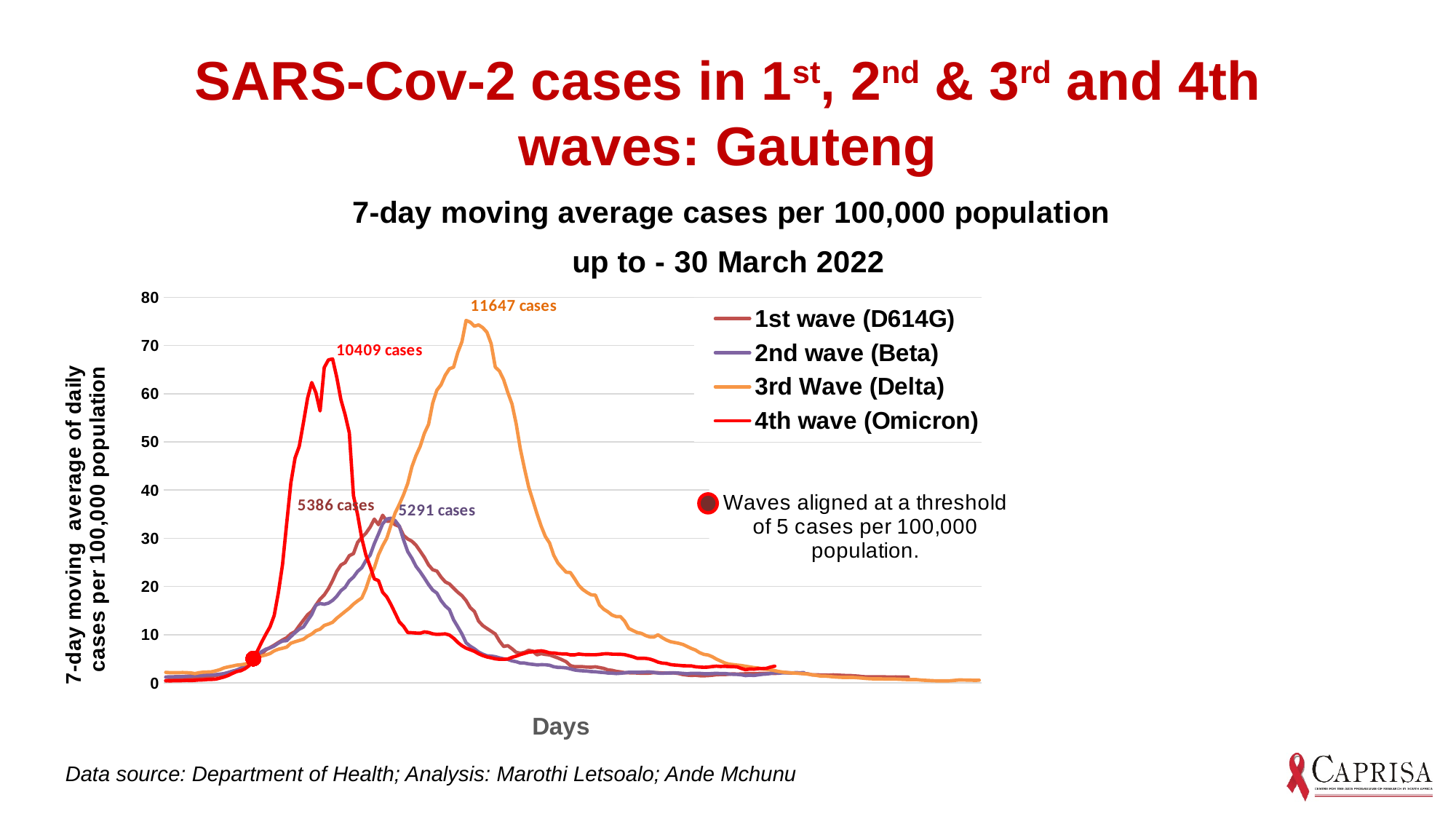
How many series does the legend list? 4 Which wave has the lowest annotated peak case count? 2nd wave (Beta) Which wave reaches the highest 7-day moving average of cases per 100,000 population? 3rd Wave (Delta) How many cases are annotated at the peak of the 3rd Wave (Delta) line? 11647 cases Is the peak of the 4th wave (Omicron) line greater or less than 70 cases per 100,000 population? less How many cases are annotated at the peak of the 2nd wave (Beta) line? 5291 cases How many cases are annotated at the peak of the 4th wave (Omicron) line? 10409 cases How many cases are annotated at the peak of the 1st wave (D614G) line? 5386 cases At what threshold of cases per 100,000 population are the waves aligned, according to the note on the chart? 5 cases per 100,000 population Is the peak of the 3rd Wave (Delta) line greater or less than 70 cases per 100,000 population? greater What is the difference between the annotated peak case counts of the 3rd Wave (Delta) and the 4th wave (Omicron)? 1238 cases What kind of chart is shown on the slide? Line chart